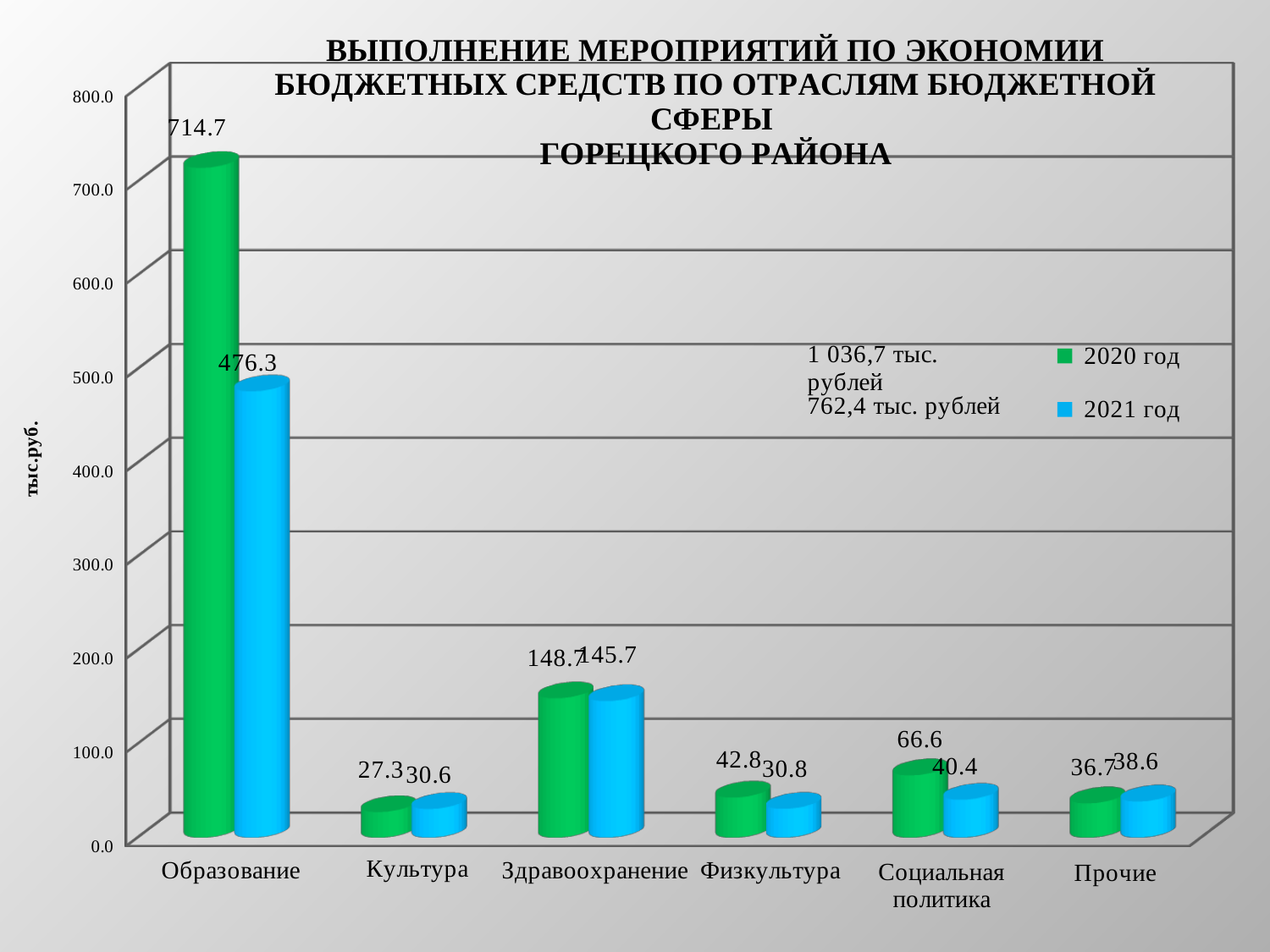
What kind of chart is shown on the slide? bar chart Which is larger for Физкультура: the 2020 год value or the 2021 год value? 2020 год Which category has the highest value in the 2020 год series? Образование Is the 2021 год value for Образование greater or less than 500? less What is the value for Здравоохранение in the 2021 год series? 145.7 How many categories are shown on the x axis? 6 How many series does the legend list? 2 What is the value for Социальная политика in the 2020 год series? 66.6 What is the value for Образование in the 2020 год series? 714.7 What is the value for Образование in the 2021 год series? 476.3 What is the difference between the 2020 год and 2021 год values for Образование? 238.4 Which category has the lowest value in the 2020 год series? Культура